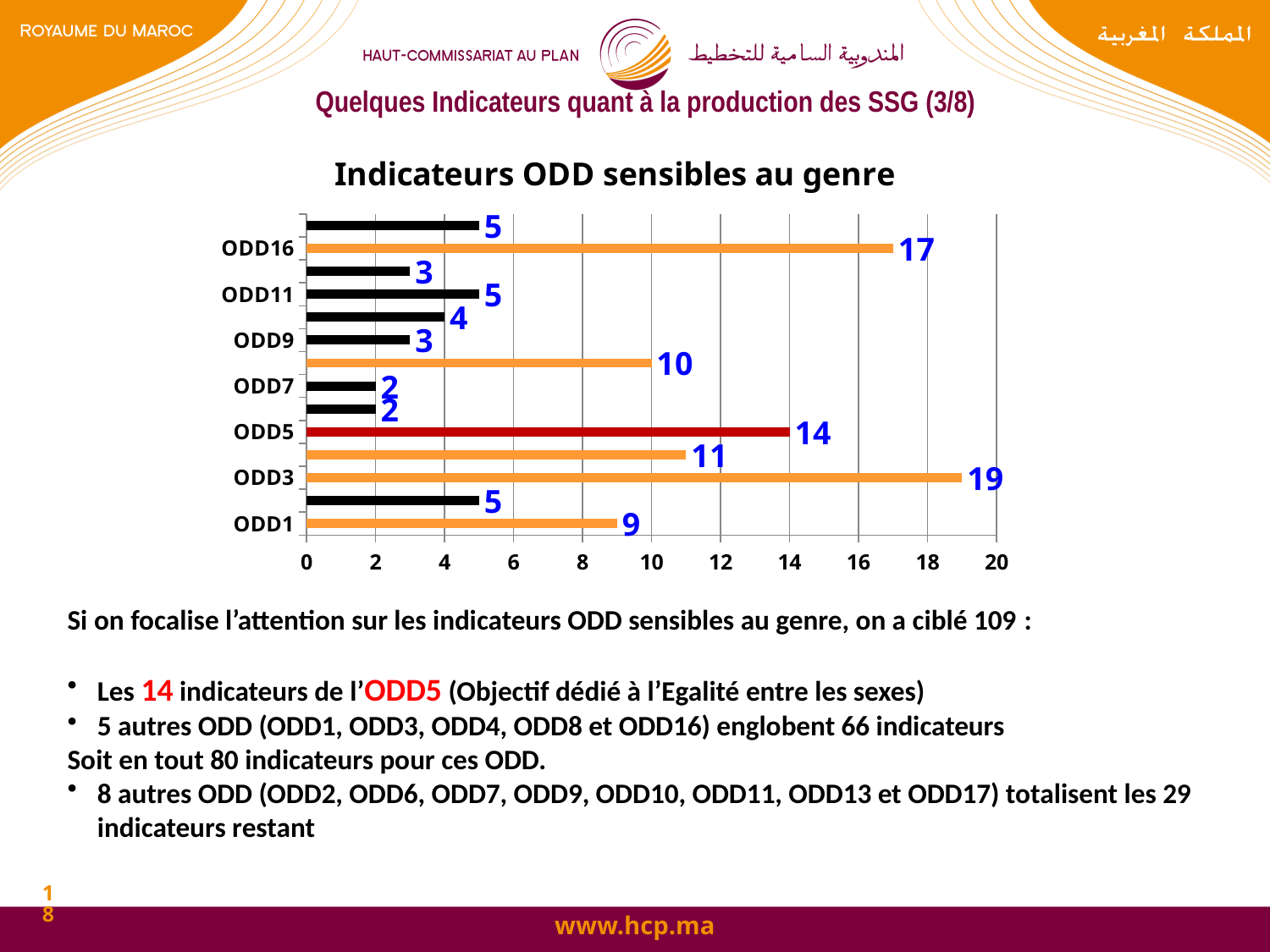
Which has a larger value, ODD9 or ODD7? ODD9 What is the difference between the values for ODD3 and ODD5? 5 How many bars are plotted in the chart? 14 What is the value for ODD11 in the chart? 5 Which has a larger value, ODD5 or ODD16? ODD16 What is the value for ODD3 in the chart? 19 What is the value for ODD5 in the chart? 14 What is the value for ODD1 in the chart? 9 Which ODD has the highest value in the chart? ODD3 What type of chart is shown on the slide? Bar chart What is the difference between the values for ODD16 and ODD1? 8 What is the value for ODD16 in the chart? 17